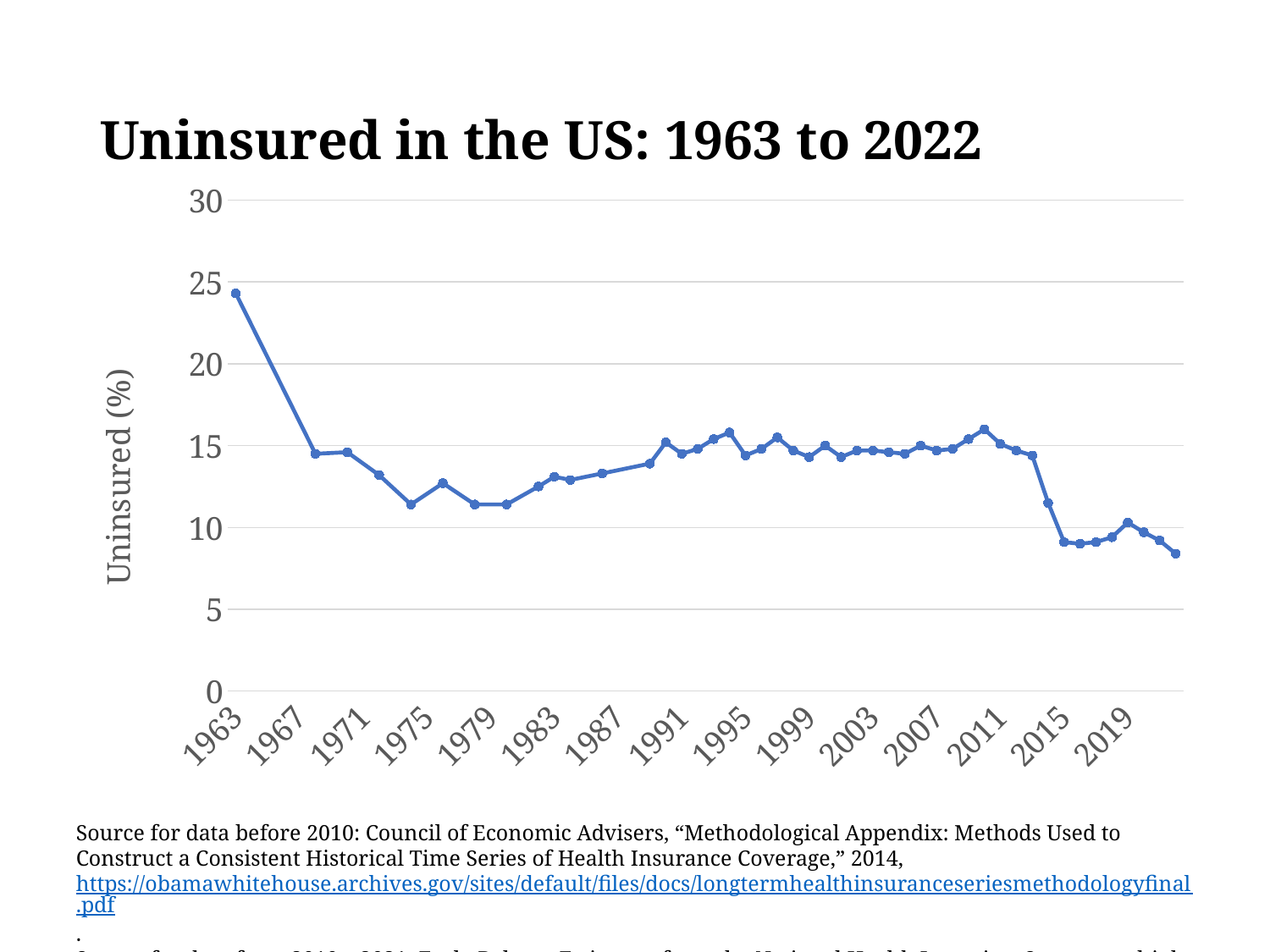
What is the title of the chart? Uninsured in the US: 1963 to 2022 Is the uninsured rate for 2022 greater or less than 10? less Overall, does the uninsured rate rise or fall from 1963 to 2022? Fall What is the label on the vertical axis of the chart? Uninsured (%) Which year has the highest uninsured rate on the chart? 1963 Is the uninsured rate for 1963 greater or less than 20? greater Which year has the lowest uninsured rate on the chart? 2022 Is the uninsured rate for 2015 greater or less than 10? less What kind of chart is shown on the slide? Line chart